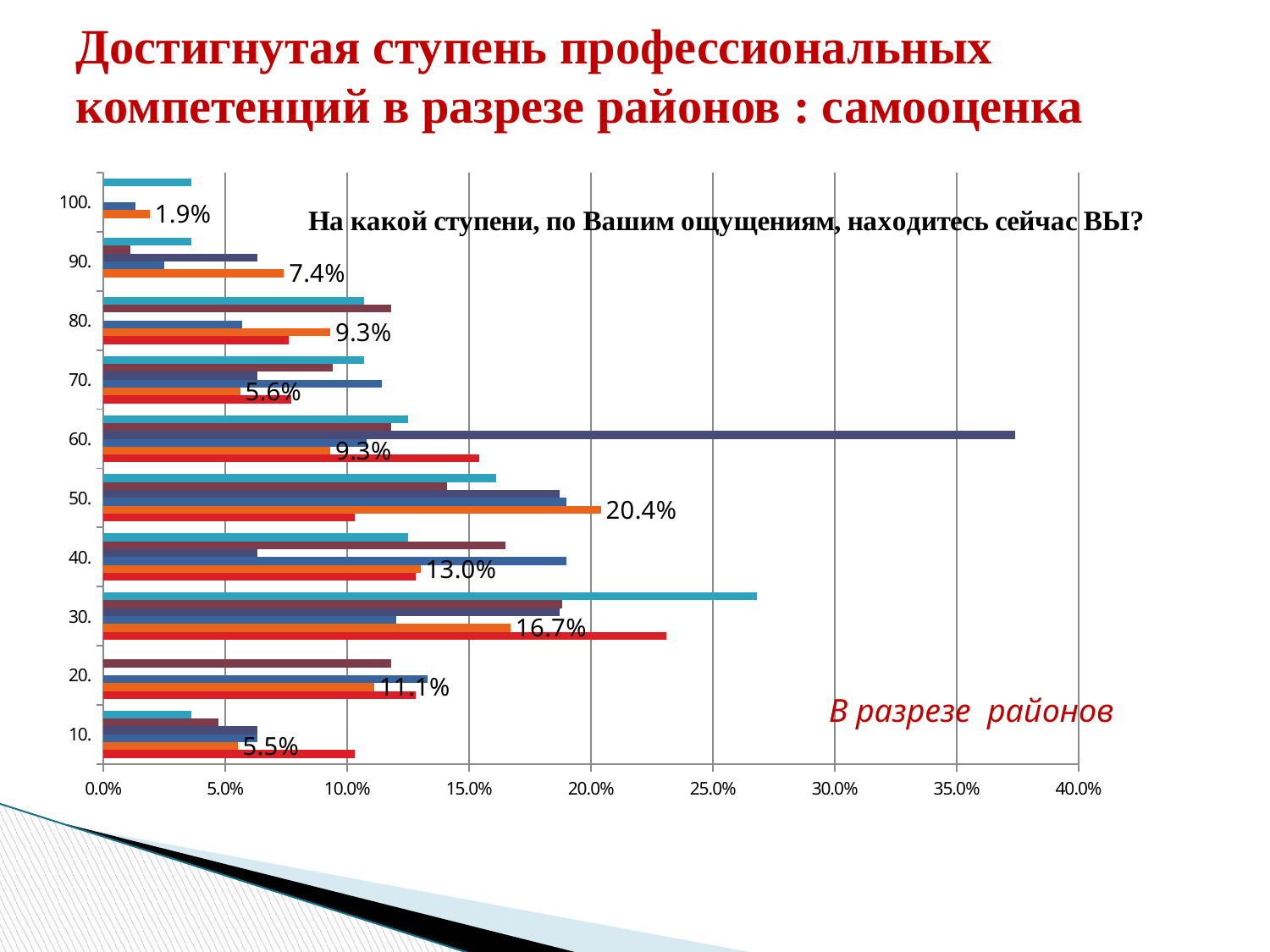
Which is larger for the orange series: the labelled value for step 40 or for step 20? step 40 What is the labelled value of the orange series for step 100? 1.9% Among the labelled orange-series values, which step has the highest value? 50 Among the labelled orange-series values, which step has the lowest value? 100 What is the difference between the labelled orange-series values for step 50 and step 30? 3.7% What is the labelled value of the orange series for step 30? 16.7% How many categories (steps) are listed on the vertical axis of the chart? 10 What kind of chart is shown on the slide? bar chart What is the labelled value of the orange series for step 10? 5.5% Is the value of the longest bar in the chart (the dark purple bar at step 60) greater or less than 35.0%? greater What question is written as the title inside the chart area? На какой ступени, по Вашим ощущениям, находитесь сейчас ВЫ? What is the labelled value of the orange series for step 50? 20.4%